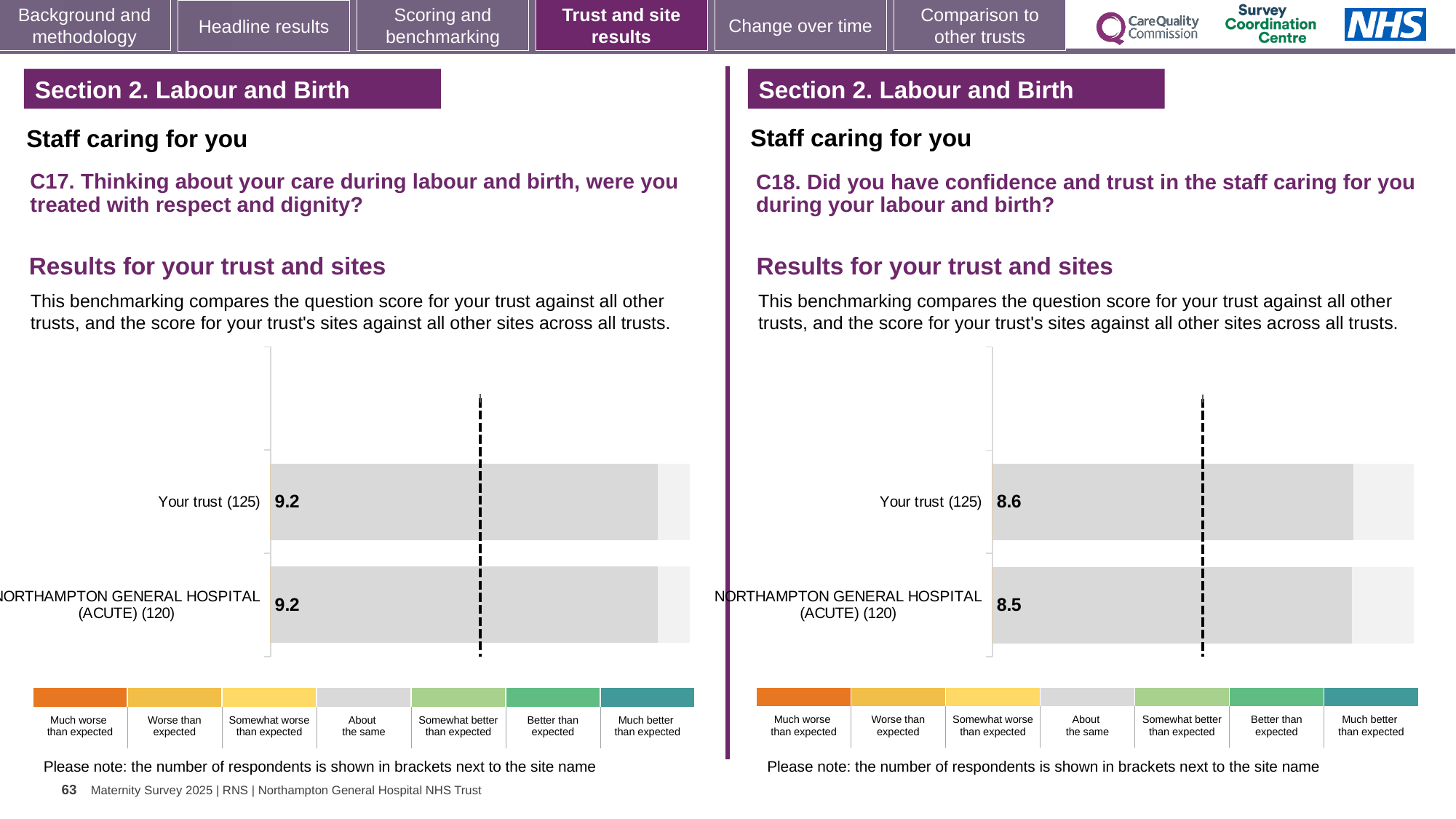
On the C18 chart (right), which has the higher score: Your trust (125) or Northampton General Hospital (Acute) (120)? Your trust (125) How many benchmark categories are shown in the colour key below the C17 chart (left)? 7 What type of chart is used for the C17 results (left)? Bar chart How many bars are plotted on the C17 chart (left)? 2 On the C17 chart (left), what is the score for Northampton General Hospital (Acute) (120)? 9.2 On the C17 chart (left), what is the score for Your trust (125)? 9.2 On the C18 chart (right), what is the score for Your trust (125)? 8.6 On the C18 chart (right), what is the difference between the score for Your trust (125) and the score for Northampton General Hospital (Acute) (120)? 0.1 On the C17 chart (left), what is the difference between the score for Your trust (125) and the score for Northampton General Hospital (Acute) (120)? 0 How many bars are plotted on the C18 chart (right)? 2 How many respondents are shown in brackets for Northampton General Hospital (Acute) on the C18 chart (right)? 120 On the C18 chart (right), what is the score for Northampton General Hospital (Acute) (120)? 8.5